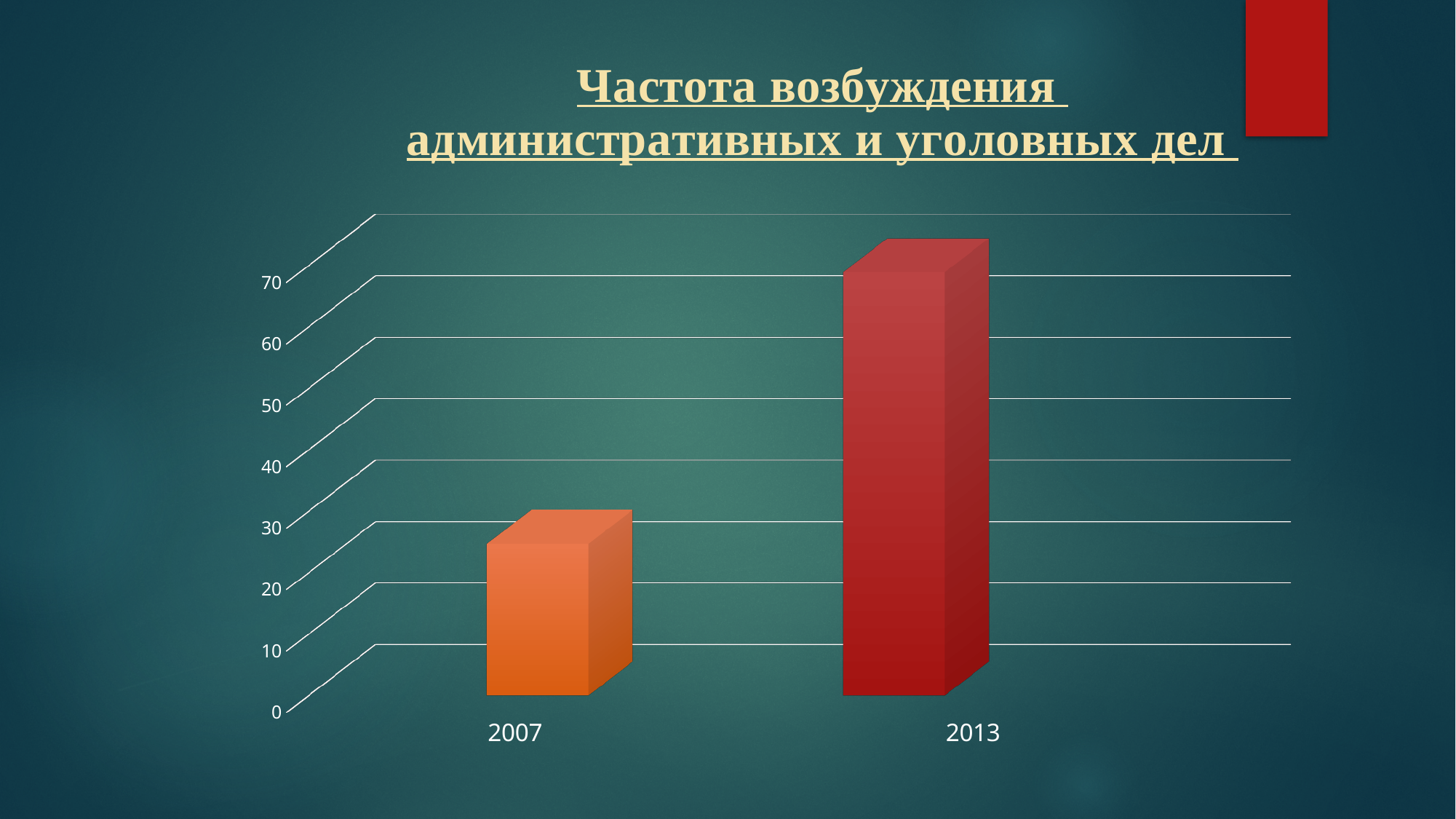
What is the title of the slide above the chart? Частота возбуждения административных и уголовных дел How many categories are shown on the x axis of the chart? 2 Is the value for 2007 greater or less than 10? greater Which year has the highest bar in the chart? 2013 Which is larger, the value for 2007 or the value for 2013? 2013 Is the value for 2013 greater or less than 50? greater Do the values rise or fall from 2007 to 2013? rise Is the value for 2013 greater or less than 60? greater What kind of chart is shown on the slide? bar chart Which year has the lowest bar in the chart? 2007 What is the highest value labelled on the vertical axis of the chart? 70